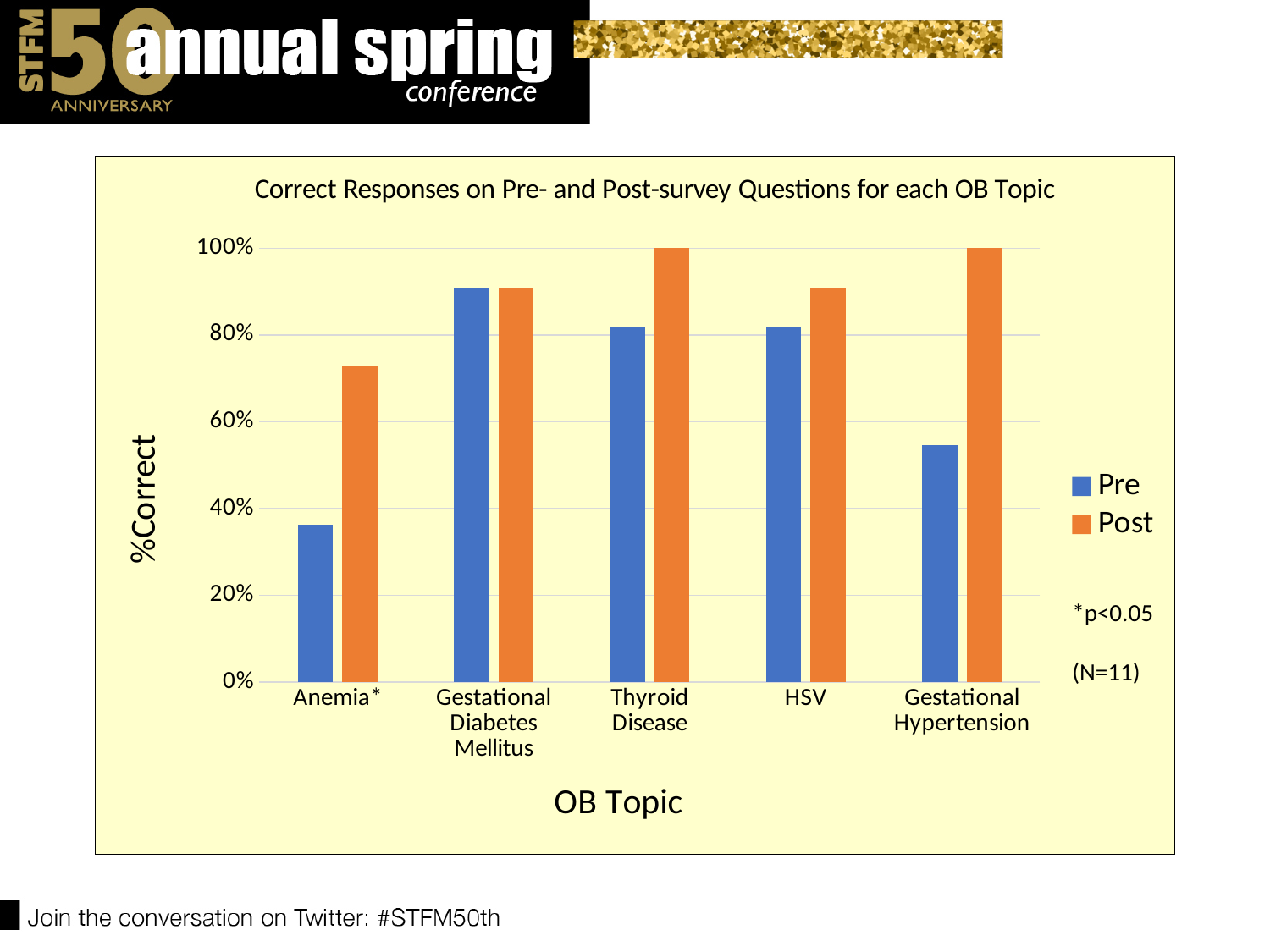
Is the Pre value for Anemia greater or less than 40%? less What is the title of the chart? Correct Responses on Pre- and Post-survey Questions for each OB Topic How many OB topics are shown on the x axis of the chart? 5 Which OB topic has the lowest Pre value? Anemia What is the Post value for Gestational Hypertension? 100% How many series does the chart's legend list? 2 Is the Pre value for Gestational Hypertension greater or less than 60%? less What type of chart is shown on the slide? Bar chart What is the label on the chart's y axis? %Correct Is the Post value for Anemia greater or less than 60%? greater What is the Post value for Thyroid Disease? 100% For Anemia, which is larger, the Pre value or the Post value? Post